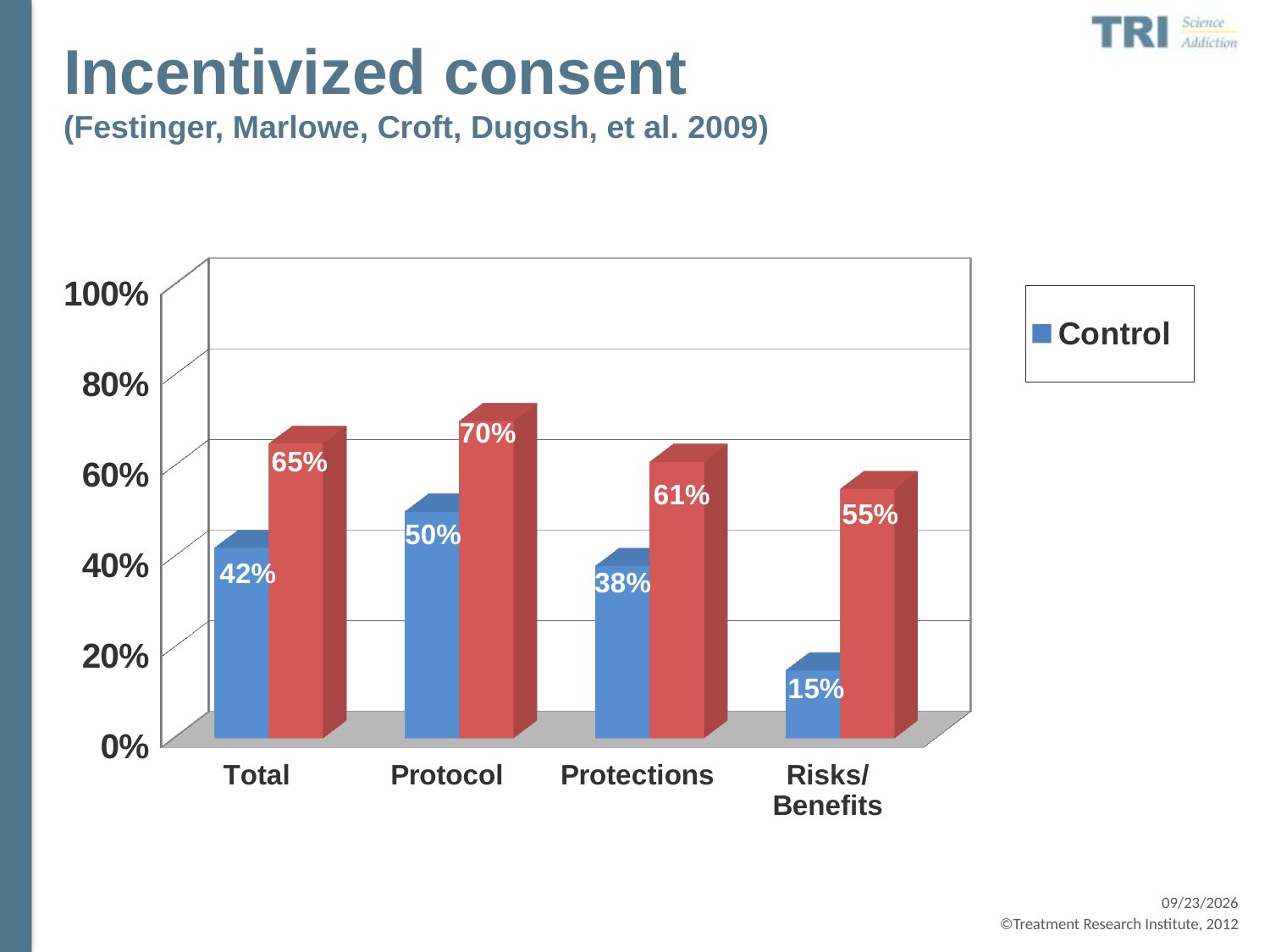
How many series does the legend list? 1 How many categories are shown on the x axis? 4 For Risks/Benefits, how much higher is the red bar value than the Control value? 40% Which category has the lowest Control value? Risks/Benefits Which category has the highest value among the red bars? Protocol What kind of chart is shown on the slide? Bar chart What is the Control value for Protocol? 50% For Total, what is the difference between the red bar value and the Control value? 23% What value is shown on the red bar for Protections? 61% What is the Control value for Risks/Benefits? 15% Which is larger: the Control value for Total or the Control value for Protections? Total Which category has the highest Control value? Protocol